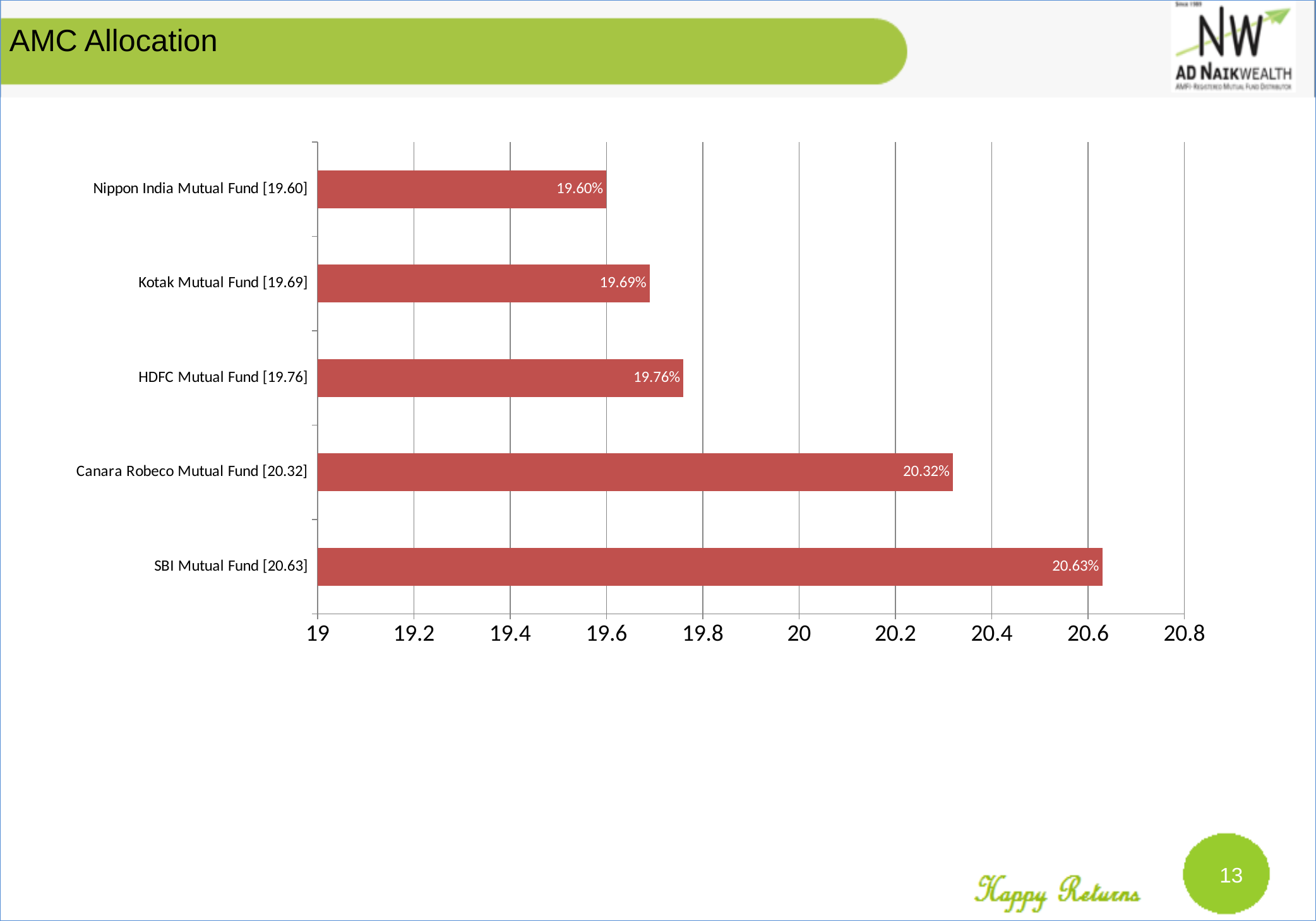
What is the value for SBI Mutual Fund? 20.63% How many funds are shown in the chart? 5 Which is larger, the value for HDFC Mutual Fund or the value for Kotak Mutual Fund? HDFC Mutual Fund What is the difference between the values for SBI Mutual Fund and Nippon India Mutual Fund? 1.03% Is the value for Canara Robeco Mutual Fund greater or less than 20? greater What kind of chart is shown on the slide? Bar chart What is the value for Canara Robeco Mutual Fund? 20.32% What is the value for Kotak Mutual Fund? 19.69% Which fund has the lowest allocation? Nippon India Mutual Fund What is the title of the slide? AMC Allocation Which fund has the highest allocation? SBI Mutual Fund What is the difference between the values for Canara Robeco Mutual Fund and HDFC Mutual Fund? 0.56%